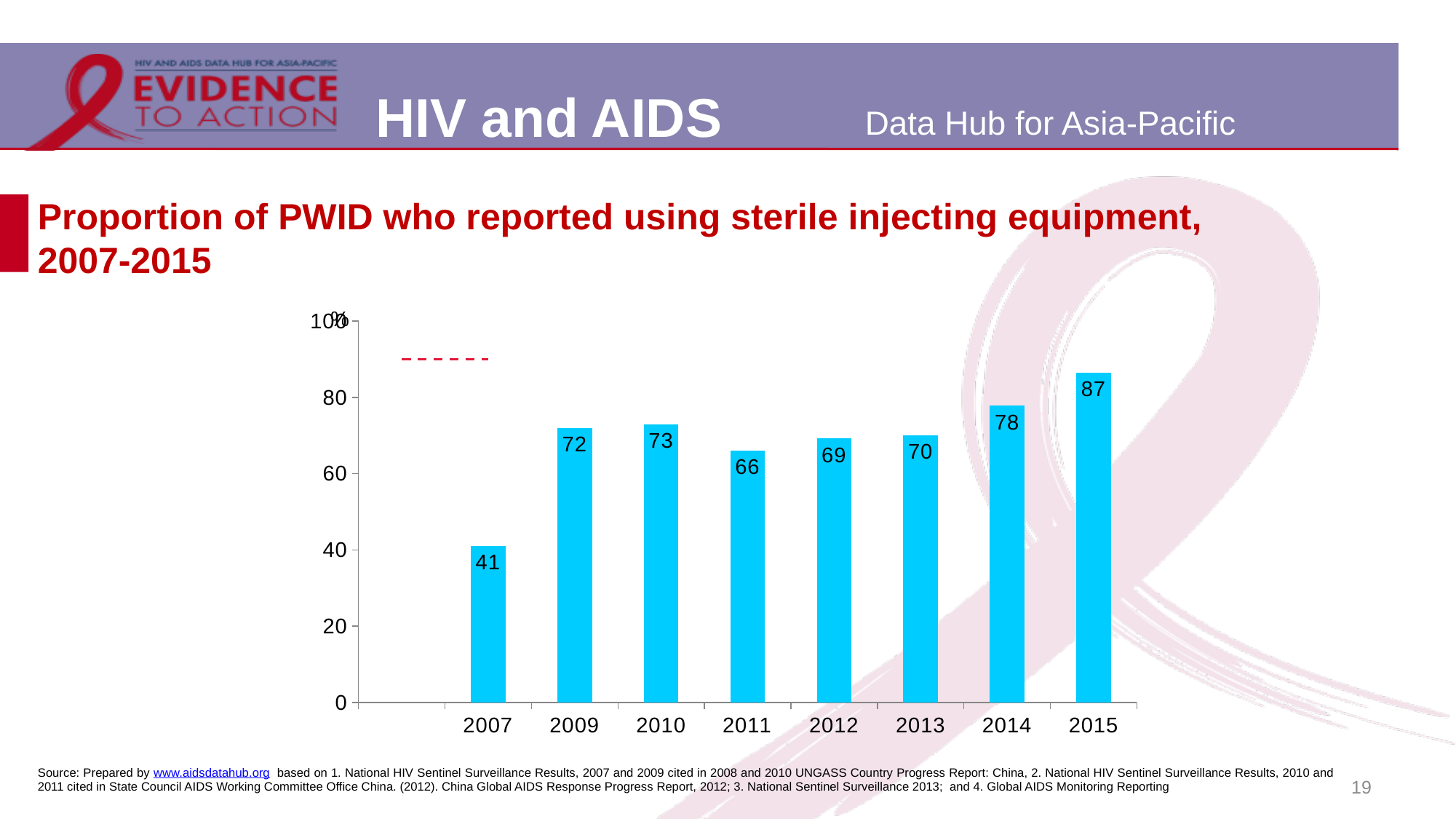
Which year has the highest value? 2015 What is the value for 2014? 78 What is the difference between the values for 2015 and 2007? 46 Is the value for 2012 greater or less than 60? greater What is the value for 2007? 41 What is the value for 2011? 66 Which is larger, the value for 2009 or the value for 2013? 2009 How many years are shown on the x axis? 8 Which year has the lowest value? 2007 What is the title of the chart? Proportion of PWID who reported using sterile injecting equipment, 2007-2015 What kind of chart is shown on the slide? bar chart What is the difference between the values for 2010 and 2011? 7